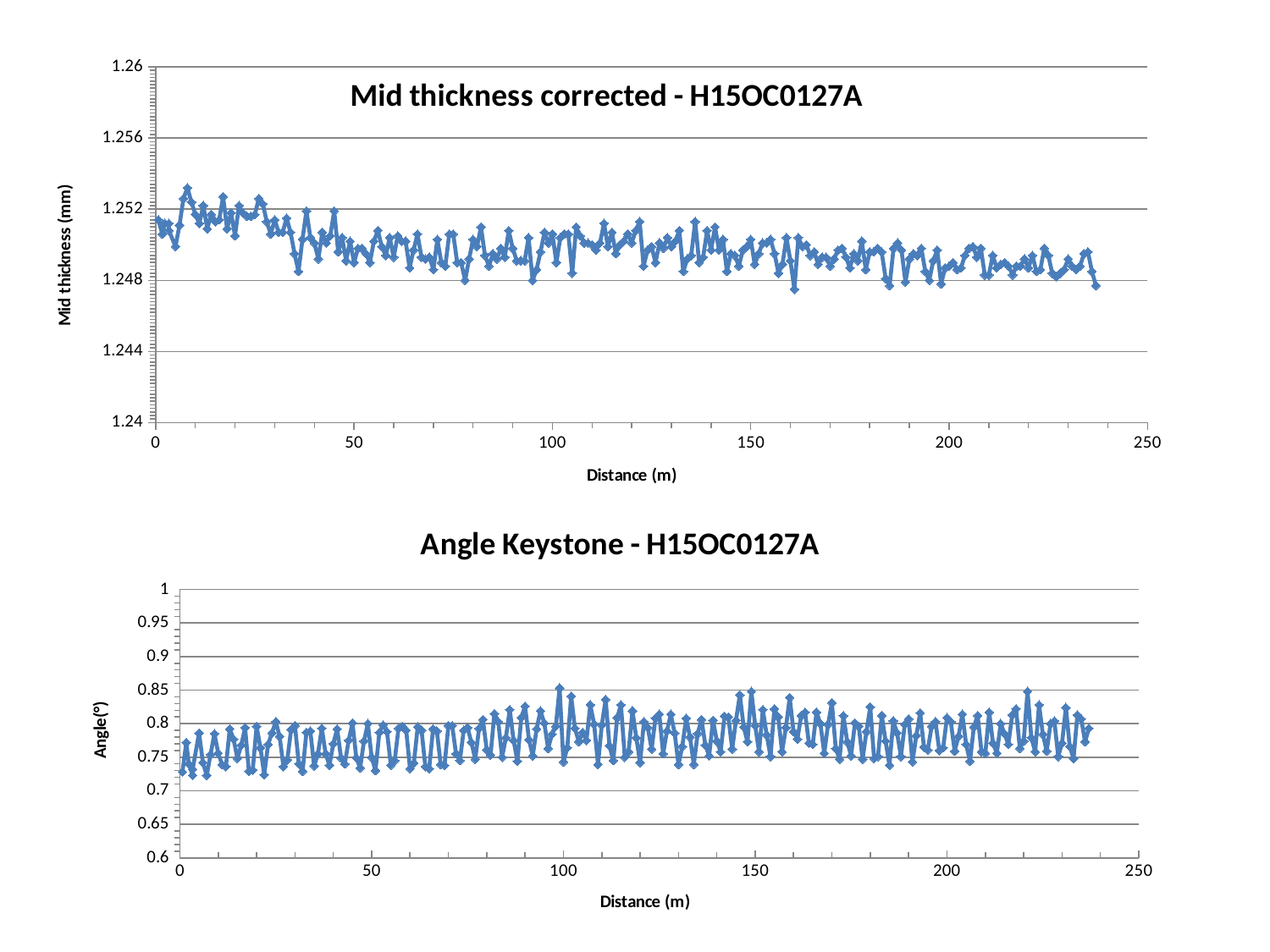
In the 'Angle Keystone - H15OC0127A' chart, is the value at a distance of 50 m greater or less than 0.7? greater In the 'Mid thickness corrected - H15OC0127A' chart, is the value at a distance of 10 m greater or less than 1.256? less In the 'Mid thickness corrected - H15OC0127A' chart, is the value at a distance of 100 m greater or less than 1.244? greater What kind of chart is the 'Angle Keystone - H15OC0127A' chart? line chart What is the label of the x axis on the 'Angle Keystone - H15OC0127A' chart? Distance (m) What is the label of the y axis on the 'Mid thickness corrected - H15OC0127A' chart? Mid thickness (mm) In the 'Mid thickness corrected - H15OC0127A' chart, do the values generally rise or fall as distance increases? fall What kind of chart is the 'Mid thickness corrected - H15OC0127A' chart? line chart